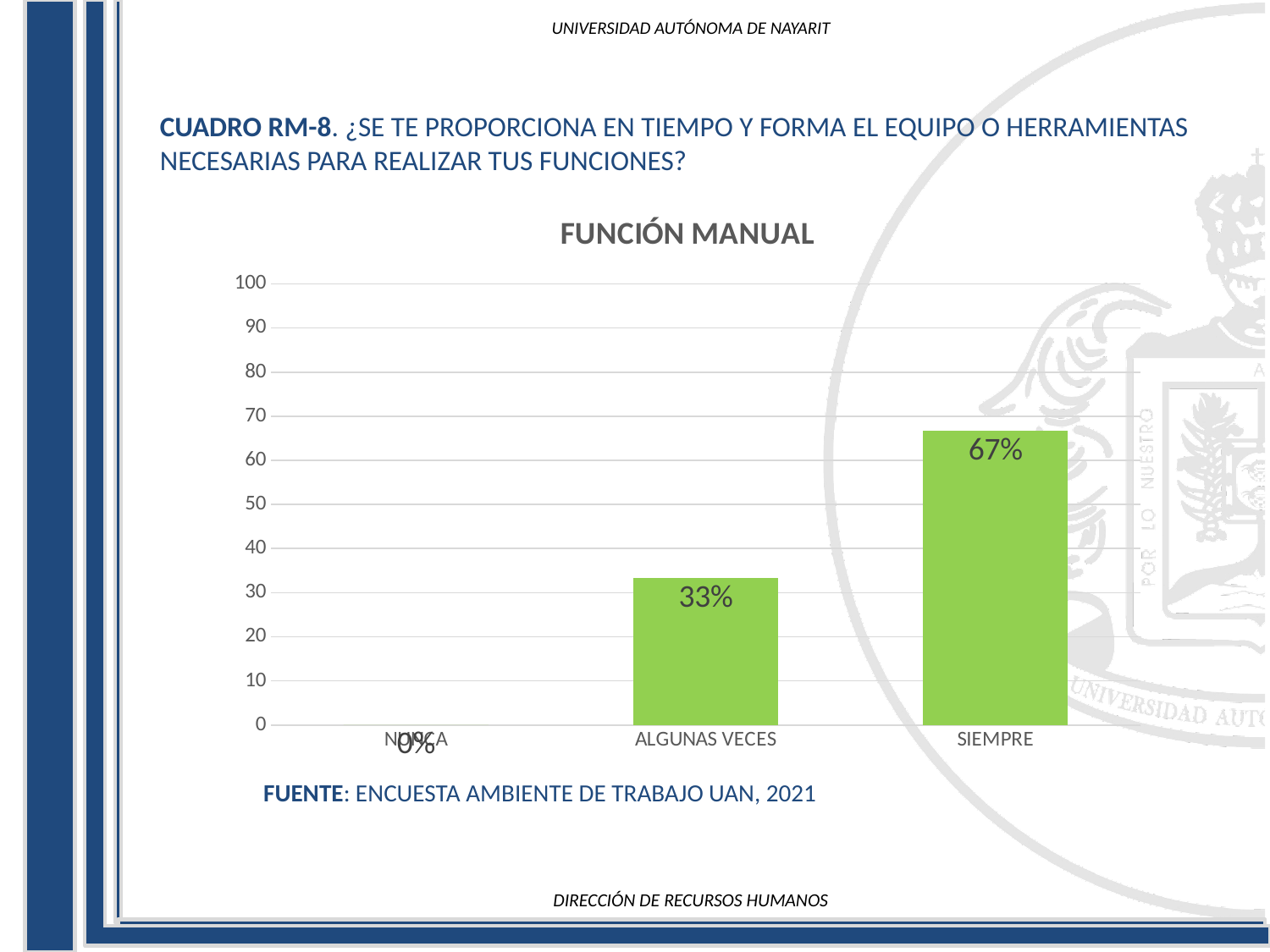
What is the value for SIEMPRE? 67% How many categories are shown on the x axis? 3 Is the value for SIEMPRE greater or less than 60? greater Is the value for ALGUNAS VECES greater or less than 40? less What is the difference between the values for SIEMPRE and ALGUNAS VECES? 34% What is the value for ALGUNAS VECES? 33% What is the title of the chart? FUNCIÓN MANUAL Which category has the highest value? SIEMPRE What kind of chart is shown? bar chart Which is larger, the value for ALGUNAS VECES or the value for SIEMPRE? SIEMPRE Which category has the lowest value? NUNCA What is the value for NUNCA? 0%